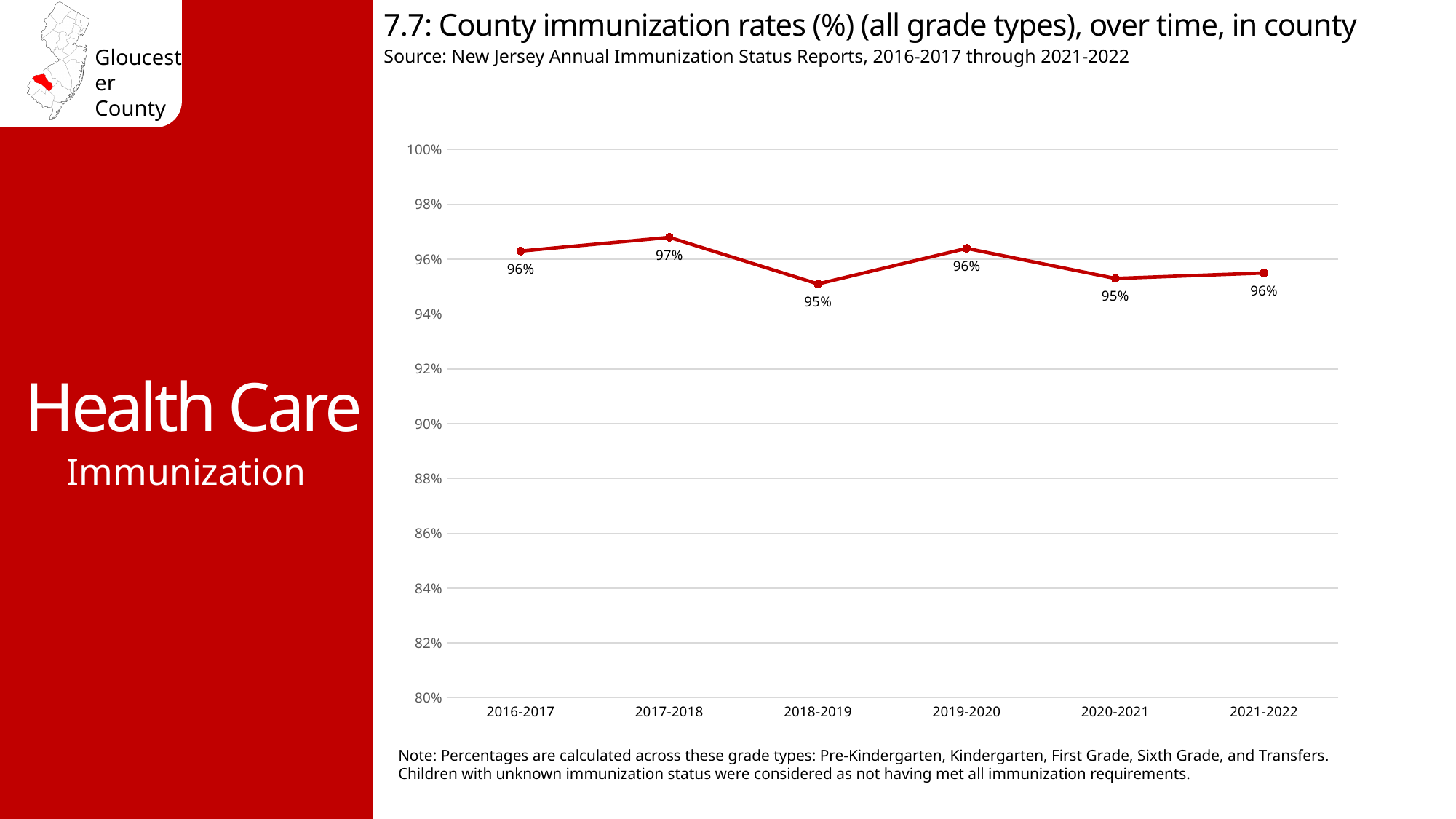
What kind of chart is shown on the slide? Line chart What is the county immunization rate for 2018-2019? 95% How many school years are plotted on the chart? 6 Is the immunization rate for 2017-2018 greater or less than 98%? less Does the immunization rate rise or fall from 2016-2017 to 2017-2018? Rise What is the difference between the immunization rate in 2017-2018 and in 2018-2019? 2 percentage points Which is larger, the immunization rate in 2017-2018 or in 2020-2021? 2017-2018 What is the county immunization rate for 2017-2018? 97% Which school year has the highest immunization rate? 2017-2018 What is the county immunization rate for 2016-2017? 96% What is the county immunization rate for 2021-2022? 96% Is the immunization rate for 2019-2020 greater or less than 94%? greater